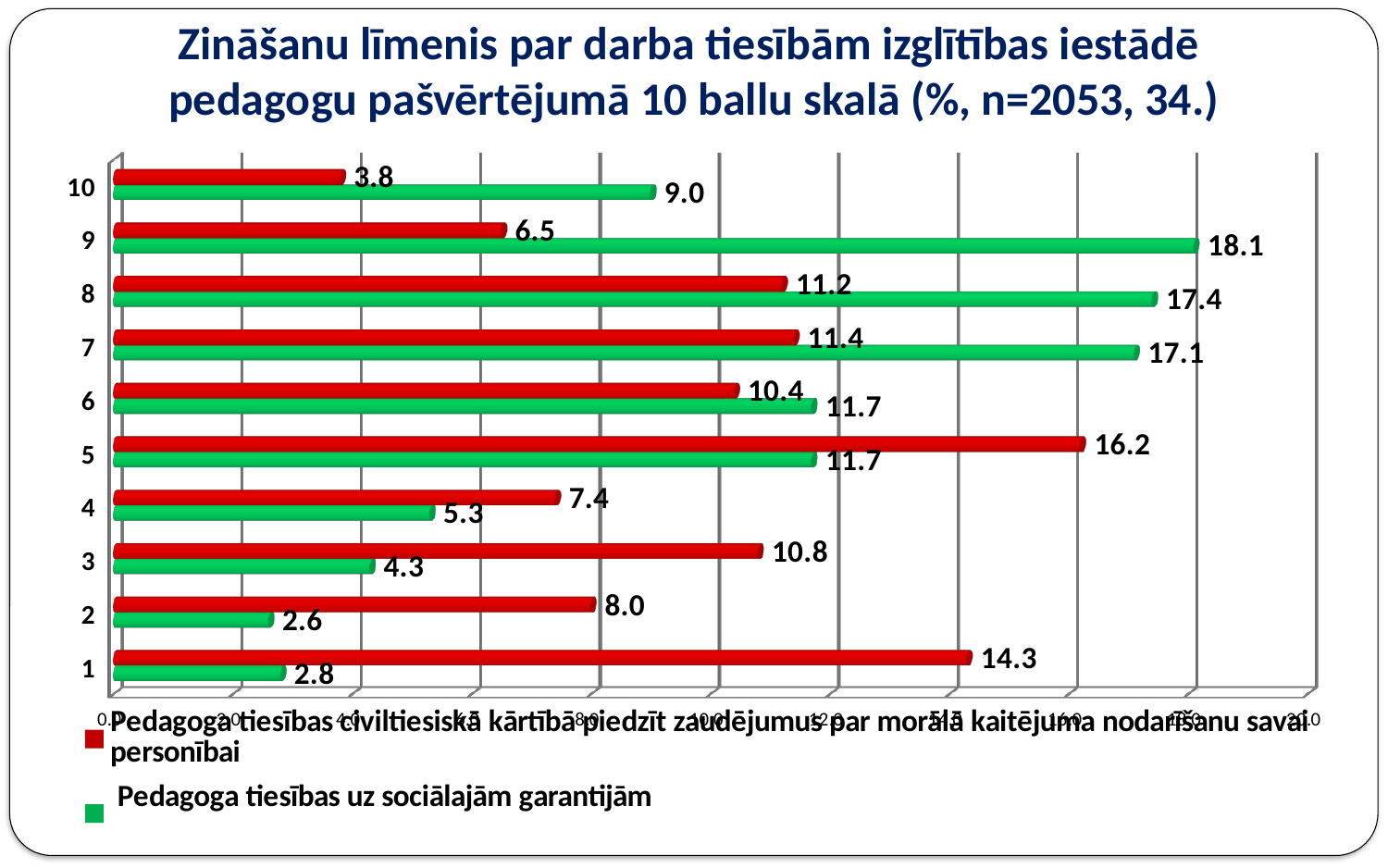
For category 3, which series has the larger value, the red or the green? red Is the red value for category 1 greater or less than 12.0? greater What is the value of the red series (Pedagoga tiesības civiltiesiskā kārtībā piedzīt zaudējumus...) for category 5? 16.2 What is the value of the green series (Pedagoga tiesības uz sociālajām garantijām) for category 9? 18.1 How many categories are shown on the vertical axis? 10 Which category has the lowest value in the red series (Pedagoga tiesības civiltiesiskā kārtībā piedzīt zaudējumus...)? 10 How many series does the legend list? 2 What colour represents the series 'Pedagoga tiesības uz sociālajām garantijām'? green What is the value of the green series (Pedagoga tiesības uz sociālajām garantijām) for category 1? 2.8 What type of chart is shown on the slide? bar chart Which category has the highest value in the green series (Pedagoga tiesības uz sociālajām garantijām)? 9 What is the difference between the green and red values for category 9? 11.6